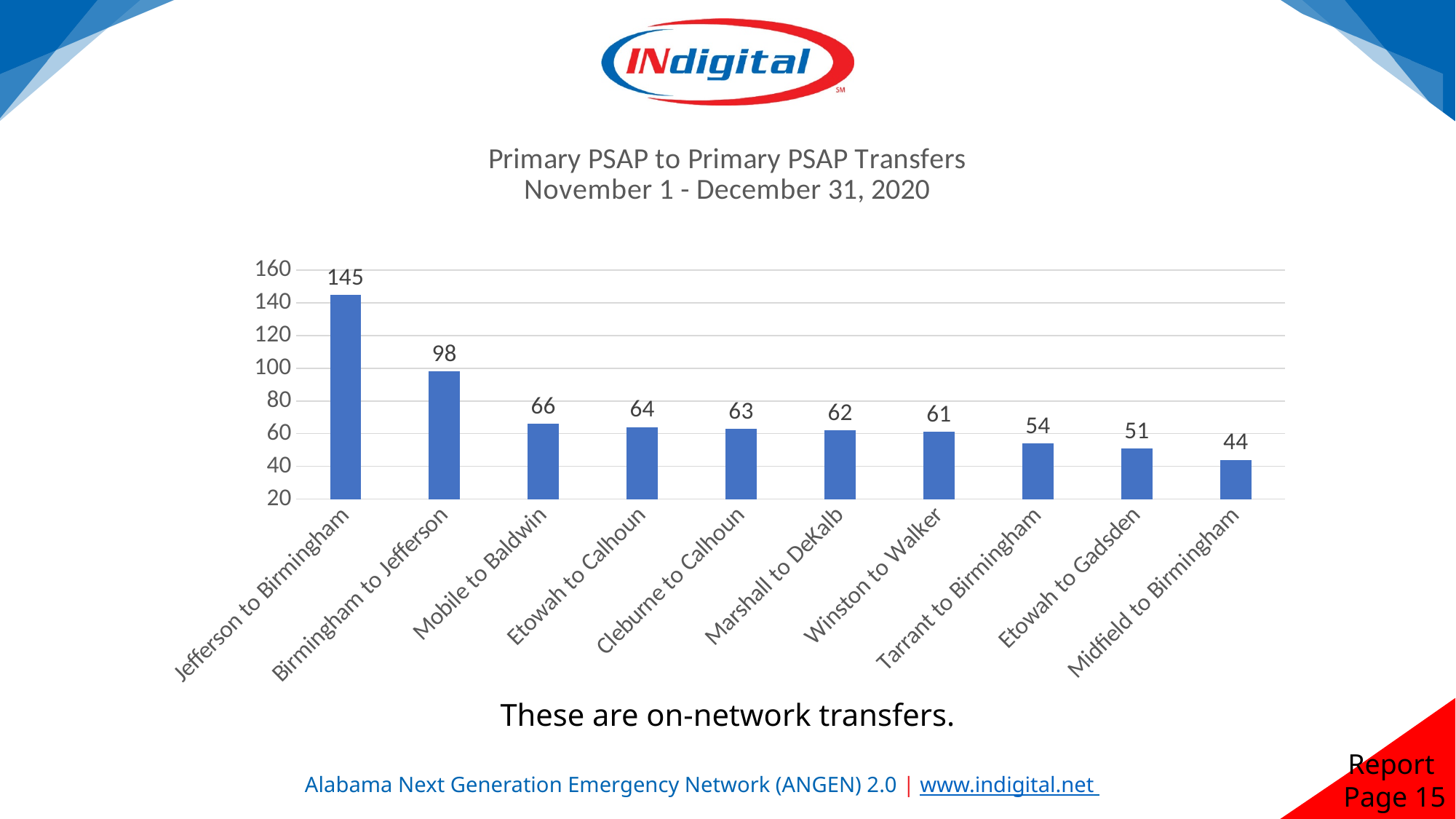
What kind of chart is shown on the slide? bar chart Which category has the highest value? Jefferson to Birmingham How many categories are shown in the chart? 10 Is the value for Winston to Walker greater or less than 80? less Which category has the lowest value? Midfield to Birmingham What is the value for Mobile to Baldwin? 66 Which is larger, Birmingham to Jefferson or Mobile to Baldwin? Birmingham to Jefferson What is the title of the chart? Primary PSAP to Primary PSAP Transfers November 1 - December 31, 2020 What is the difference between Jefferson to Birmingham and Birmingham to Jefferson? 47 What is the value for Jefferson to Birmingham? 145 What is the value for Etowah to Gadsden? 51 What is the difference between Tarrant to Birmingham and Midfield to Birmingham? 10